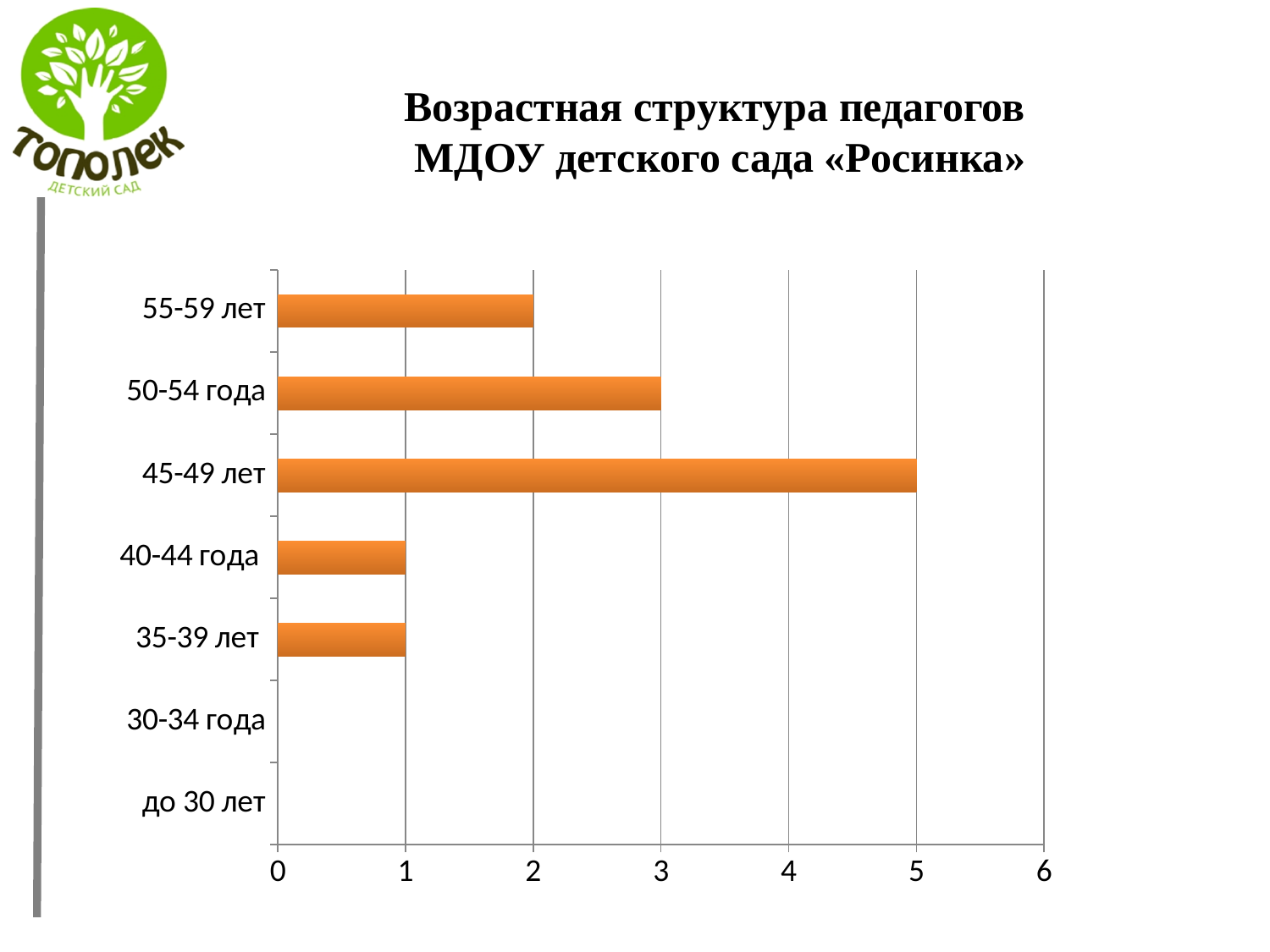
What is the value for the 50-54 года category? 3 Which age category has the highest value? 45-49 лет What is the title of the chart? Возрастная структура педагогов МДОУ детского сада «Росинка» What is the value for the 40-44 года category? 1 What is the value for the 45-49 лет category? 5 Is the value for 45-49 лет greater or less than 4? greater What is the difference between the values for 45-49 лет and 50-54 года? 2 What is the value for the 55-59 лет category? 2 Which is larger, the value for 50-54 года or the value for 55-59 лет? 50-54 года What is the maximum value shown on the horizontal axis? 6 How many age categories are listed on the vertical axis? 7 What type of chart is shown on the slide? bar chart